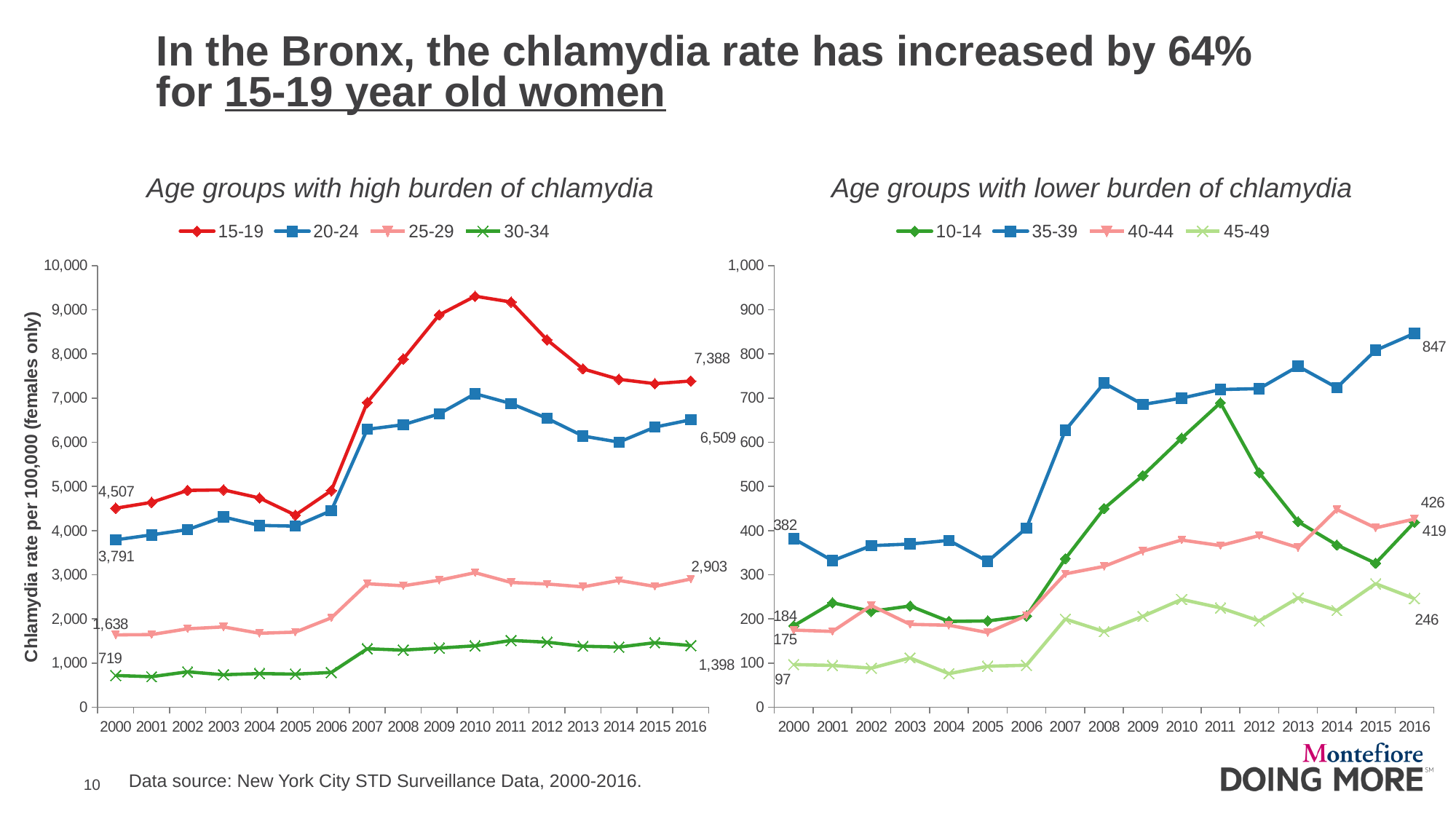
In the 'Age groups with high burden of chlamydia' chart, what is the value for the 20-24 age group in 2000? 3,791 In the 'Age groups with high burden of chlamydia' chart, by how much did the 15-19 rate increase from 2000 to 2016? 2,881 In the 'Age groups with lower burden of chlamydia' chart, is the value for the 10-14 age group in 2011 greater or less than 600? greater What kind of chart is the 'Age groups with lower burden of chlamydia' chart? Line chart In the 'Age groups with lower burden of chlamydia' chart, what is the value for the 45-49 age group in 2000? 97 In the 'Age groups with lower burden of chlamydia' chart, what is the value for the 35-39 age group in 2016? 847 In the 'Age groups with high burden of chlamydia' chart, which age group has the highest rate in 2016? 15-19 In the 'Age groups with lower burden of chlamydia' chart, what is the difference between the 35-39 values in 2016 and 2000? 465 In the 'Age groups with high burden of chlamydia' chart, is the value for the 15-19 age group in 2010 greater or less than 9,000? greater In the 'Age groups with high burden of chlamydia' chart, what is the chlamydia rate for the 15-19 age group in 2016? 7,388 How many series does the legend of the 'Age groups with high burden of chlamydia' chart list? 4 How many years are shown on the x axis of the 'Age groups with high burden of chlamydia' chart? 17